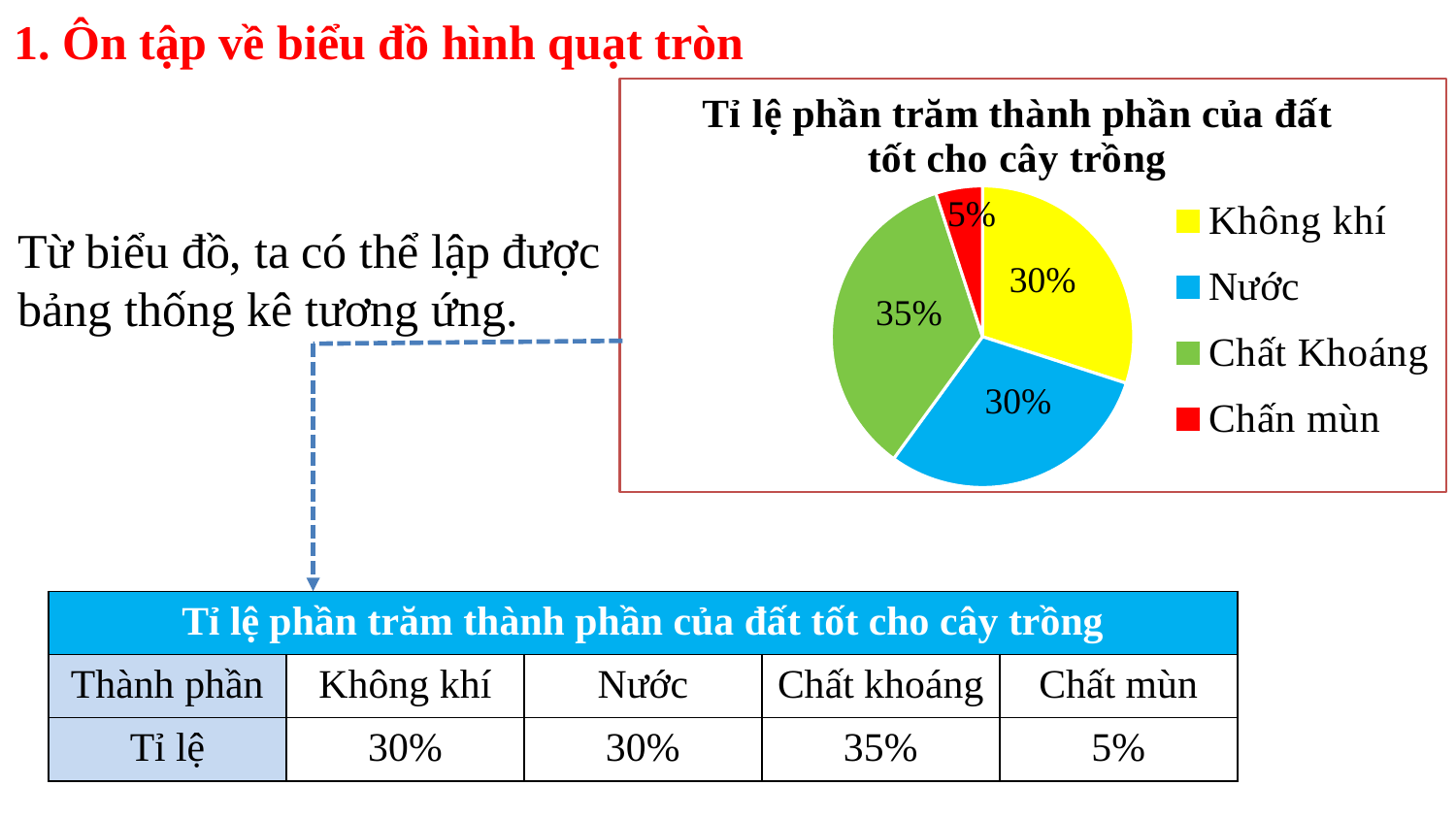
What is the difference between the Chất Khoáng slice and the Chấn mùn slice? 30% Which is larger in the pie chart, Chất Khoáng or Nước? Chất Khoáng How many slices does the pie chart have? 4 What percentage of the pie chart is Nước? 30% What percentage of the pie chart is Chấn mùn? 5% What percentage of the pie chart is Không khí? 30% Which category has the largest slice in the pie chart? Chất Khoáng What colour is the Nước slice in the pie chart? Blue What kind of chart is shown on the slide? Pie chart What is the title of the pie chart? Tỉ lệ phần trăm thành phần của đất tốt cho cây trồng Which category has the smallest slice in the pie chart? Chấn mùn What percentage of the pie chart is Chất Khoáng? 35%